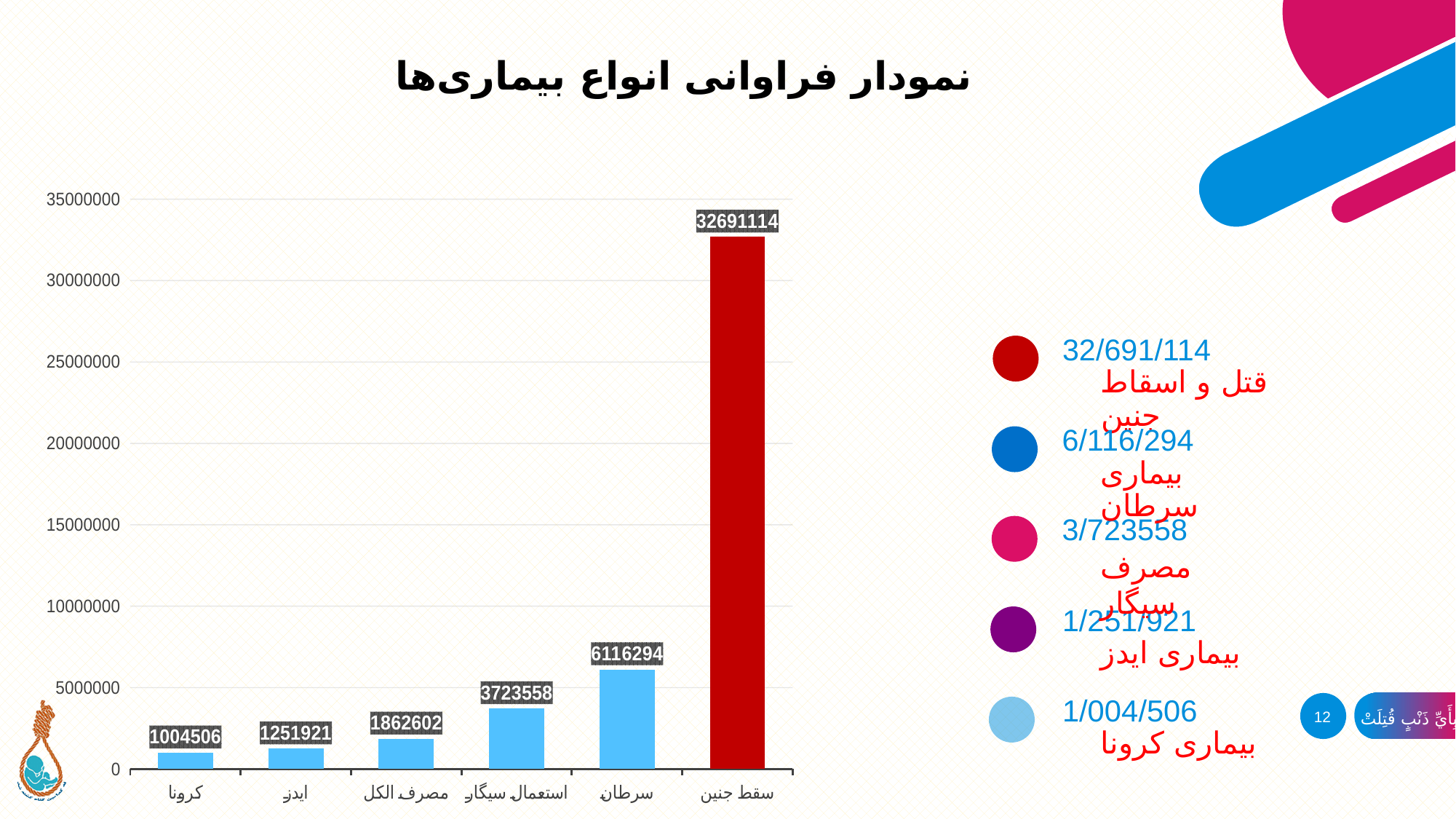
What is the value for استعمال سیگار (smoking) in the chart? 3723558 What is the value for سرطان (cancer) in the chart? 6116294 What is the value for سقط جنین (abortion) in the chart? 32691114 How many categories are plotted in the chart? 6 What type of chart is shown on the slide? Bar chart Which is larger, the value for ایدز (AIDS) or the value for کرونا (Corona)? ایدز (AIDS) Which category has the lowest value in the chart? کرونا (Corona) What is the value for مصرف الکل (alcohol consumption) in the chart? 1862602 What is the title of the chart? نمودار فراوانی انواع بیماری‌ها What is the value for کرونا (Corona) in the chart? 1004506 Which category has the highest value in the chart? سقط جنین (abortion) What is the difference between the values for سرطان (cancer) and استعمال سیگار (smoking)? 2392736